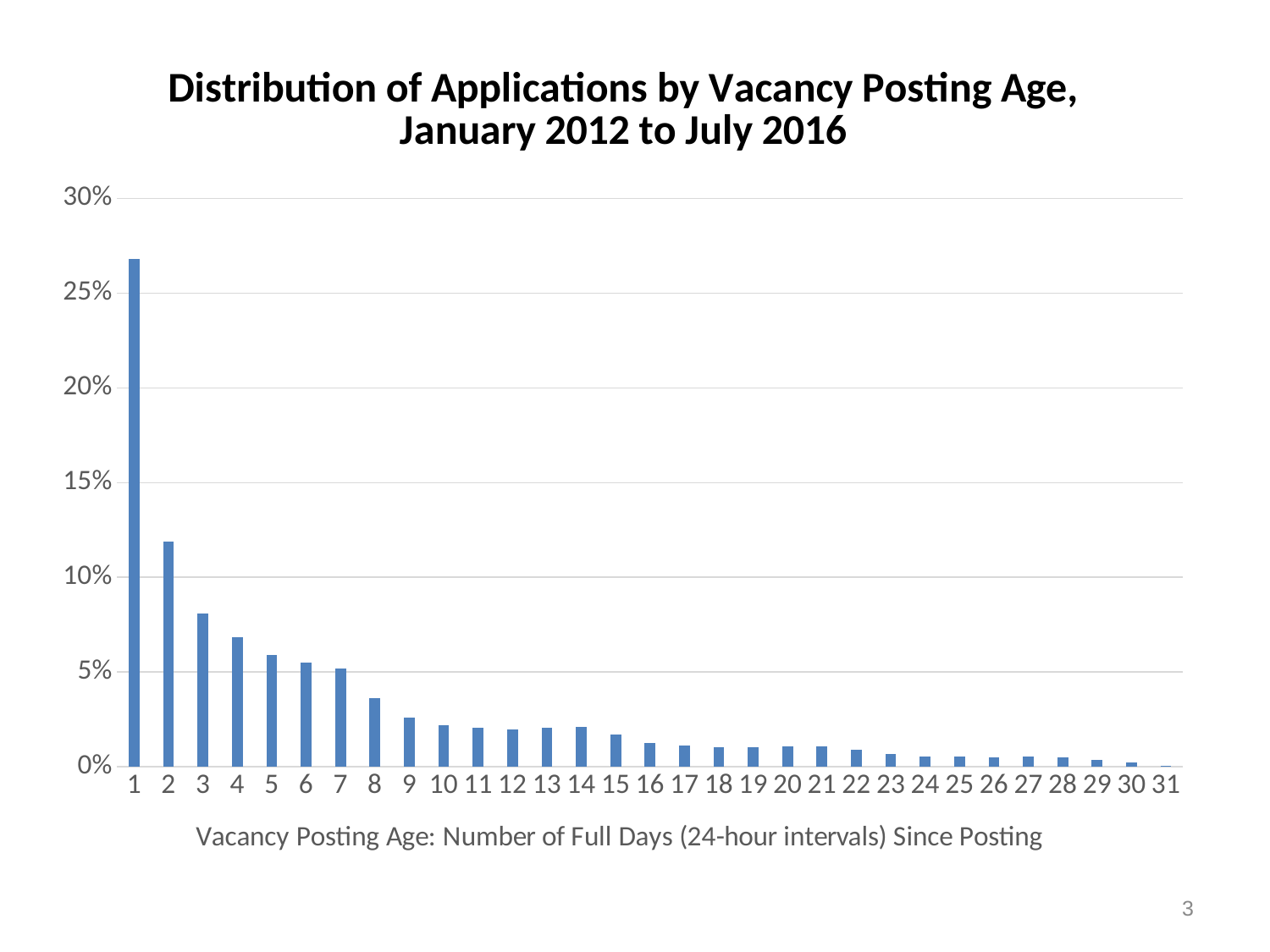
Do the values generally rise or fall as vacancy posting age increases along the x axis? fall What is the x-axis label of the chart? Vacancy Posting Age: Number of Full Days (24-hour intervals) Since Posting Which has a larger share of applications, vacancy posting age 2 or vacancy posting age 5? 2 What kind of chart is shown on the slide? bar chart Is the value for vacancy posting age 2 greater or less than 10%? greater Is the value for vacancy posting age 8 greater or less than 5%? less Is the value for vacancy posting age 1 greater or less than 25%? greater What is the title of the chart? Distribution of Applications by Vacancy Posting Age, January 2012 to July 2016 Which vacancy posting age has the lowest share of applications? 31 Which vacancy posting age has the highest share of applications? 1 How many vacancy posting age categories are plotted on the x axis? 31